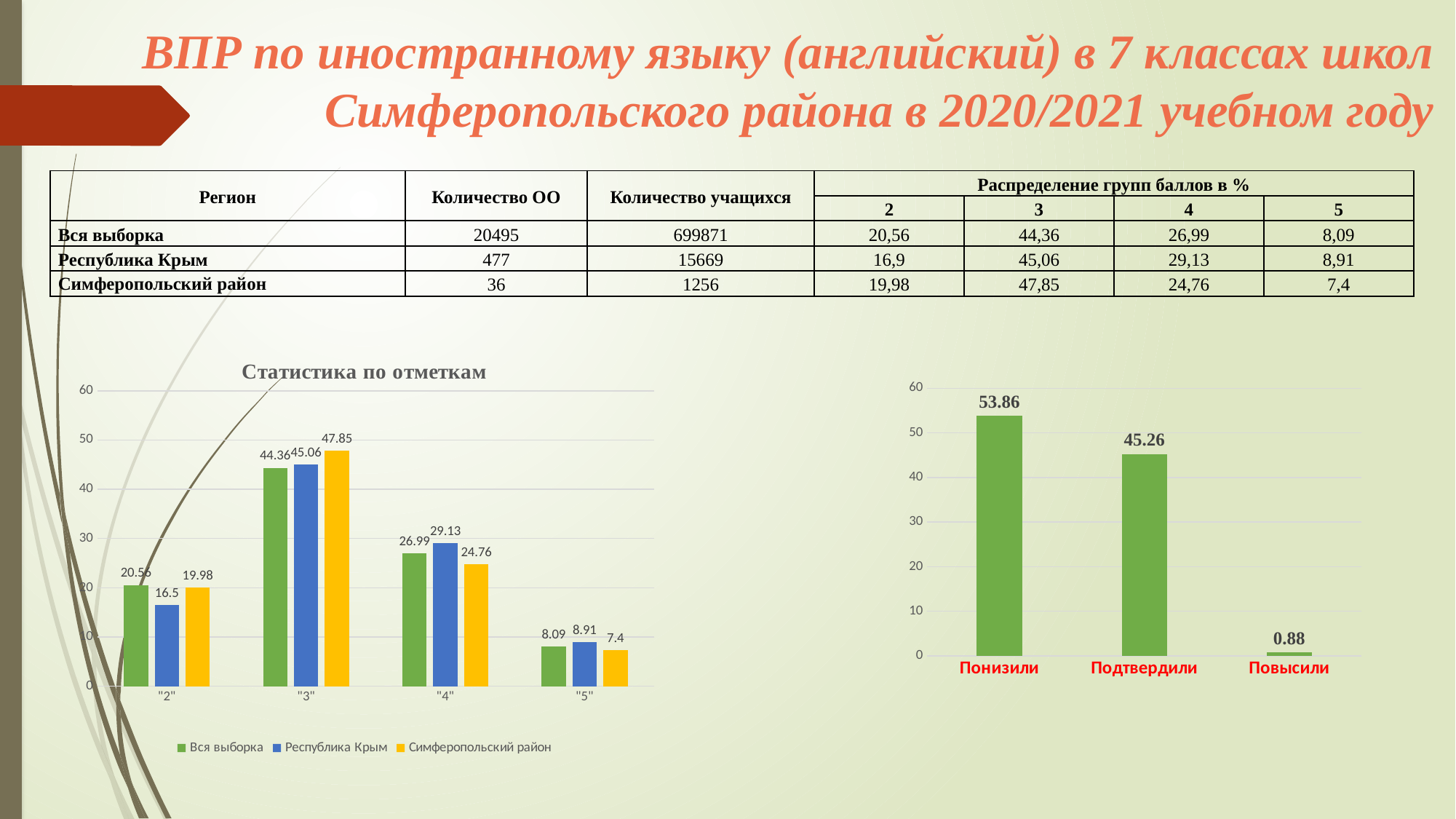
In the chart titled "Статистика по отметкам", how many mark categories are shown on the x axis? 4 In the chart titled "Статистика по отметкам", what is the difference between Республика Крым and Вся выборка at mark "4"? 2.14 In the chart on the right of the slide, which category has the lowest value? Повысили In the chart titled "Статистика по отметкам", how many series does the legend list? 3 In the chart titled "Статистика по отметкам", what is the value for Республика Крым at mark "2"? 16.5 In the chart titled "Статистика по отметкам", which mark category has the highest value for Вся выборка? "3" In the chart titled "Статистика по отметкам", what is the value for Симферопольский район at mark "3"? 47.85 In the chart titled "Статистика по отметкам", which mark category has the lowest value for Симферопольский район? "5" In the chart on the right of the slide, what is the value for Подтвердили? 45.26 In the chart on the right of the slide, what is the difference between Понизили and Подтвердили? 8.6 What kind of chart is the chart on the right of the slide? Bar chart In the chart titled "Статистика по отметкам", which is larger at mark "5": Республика Крым or Симферопольский район? Республика Крым